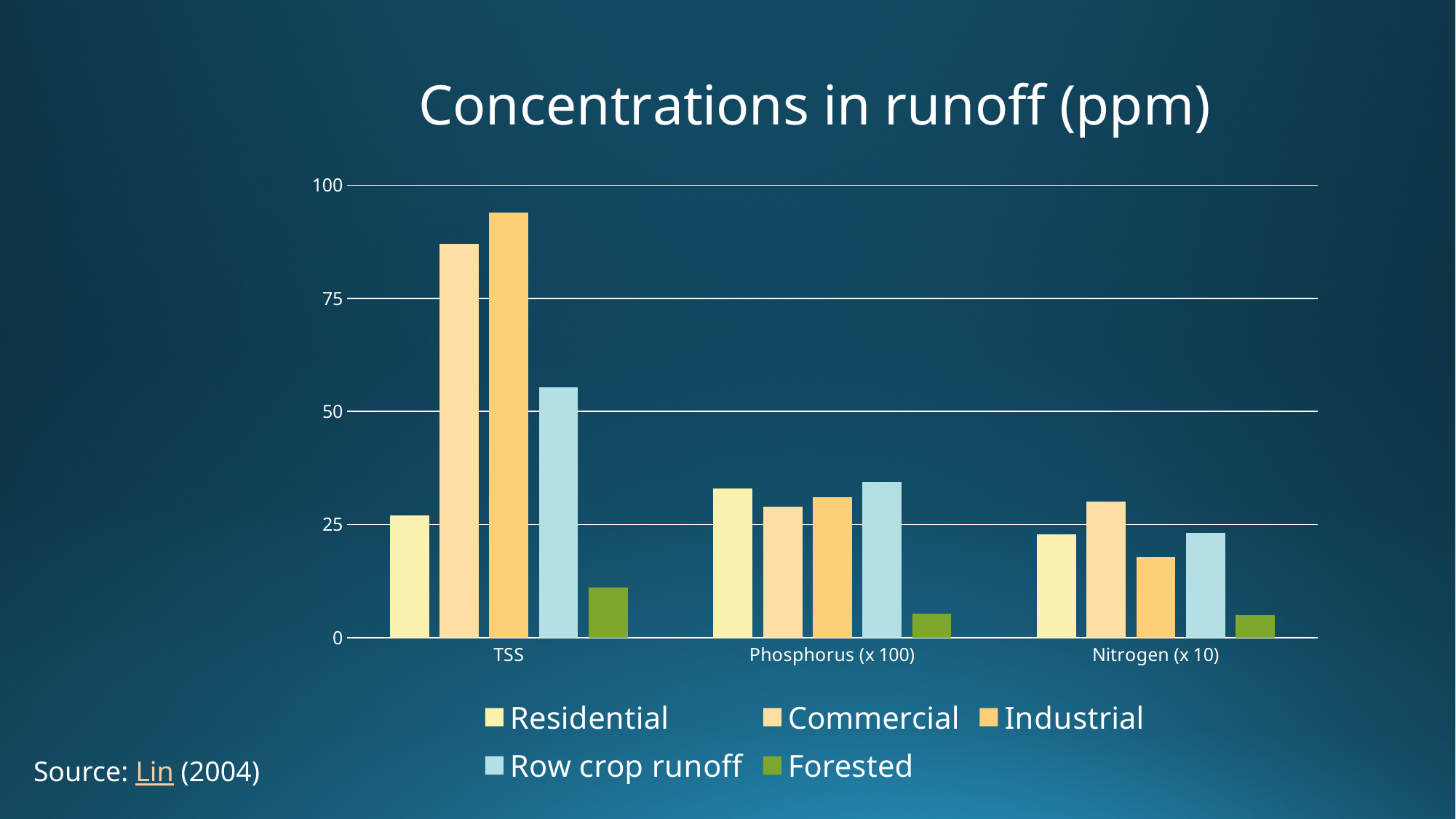
Which series has the lowest value for TSS? Forested Which series is shown in green in the legend? Forested How many series does the legend list? 5 How many categories are shown on the x axis? 3 Is the Commercial value for TSS greater or less than 75? greater For TSS, which is larger: the Commercial value or the Row crop runoff value? Commercial Which series has the lowest value for Phosphorus (x 100)? Forested Which series has the highest value for TSS? Industrial What kind of chart is shown on the slide? bar chart What is the title of the chart? Concentrations in runoff (ppm) Which series has the highest value for Nitrogen (x 10)? Commercial Is the Industrial value for Nitrogen (x 10) greater or less than 25? less